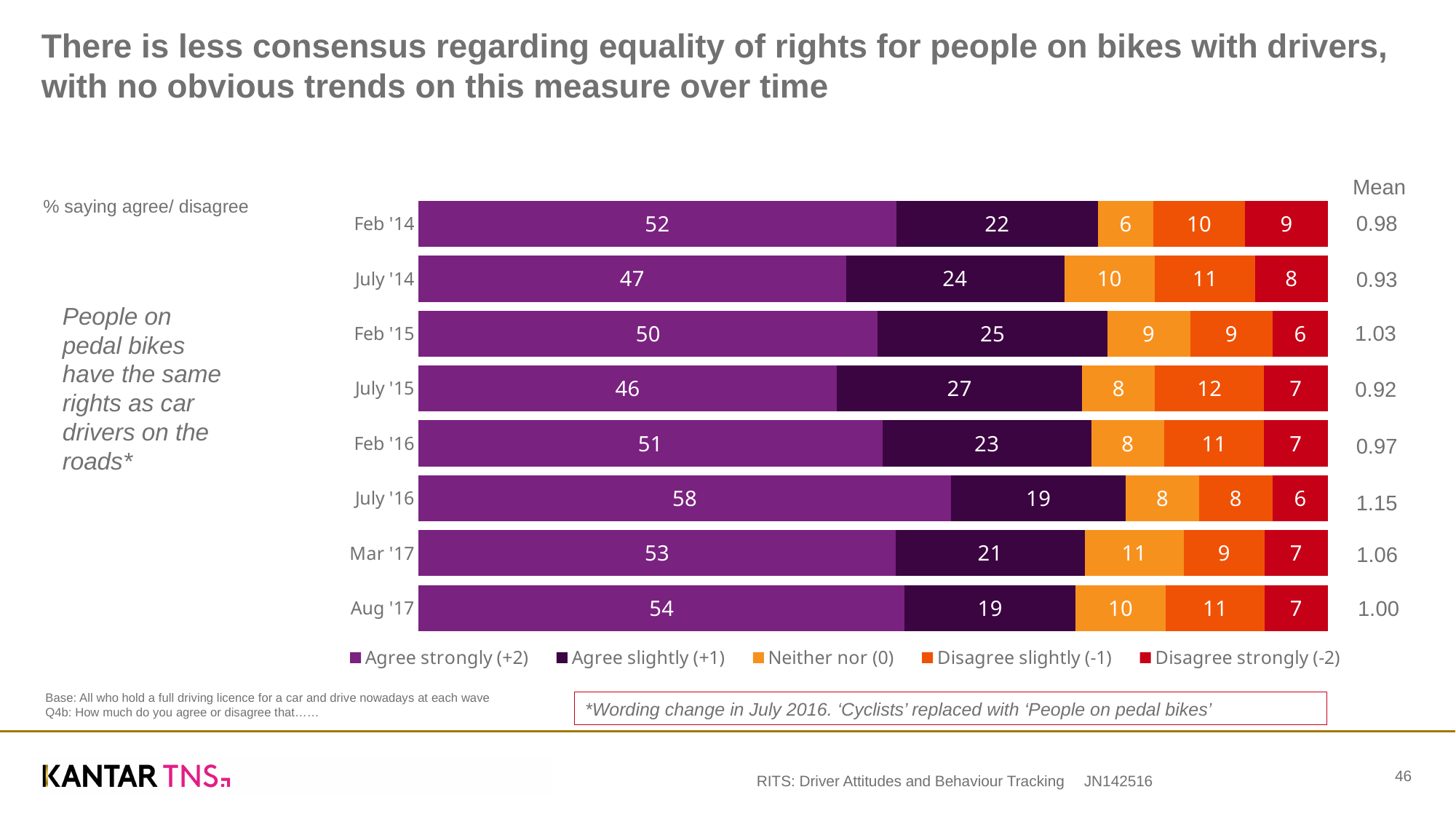
What kind of chart is shown on the slide? Stacked bar chart What is the difference between the 'Agree strongly (+2)' values for July '16 and July '15? 12 How many series does the legend list? 5 Which wave has the highest mean score shown to the right of the chart? July '16 How many waves (bars) are shown in the chart? 8 Which is larger, the 'Agree slightly (+1)' value for July '15 or for Aug '17? July '15 Which wave has the highest 'Agree strongly (+2)' value? July '16 What is the total of the Feb '14 bar across all five segments? 99 Which wave has the lowest 'Agree strongly (+2)' value? July '15 What is the 'Neither nor (0)' value for Mar '17? 11 What is the 'Disagree slightly (-1)' value for July '15? 12 What percentage of respondents said 'Agree strongly (+2)' in July '16? 58